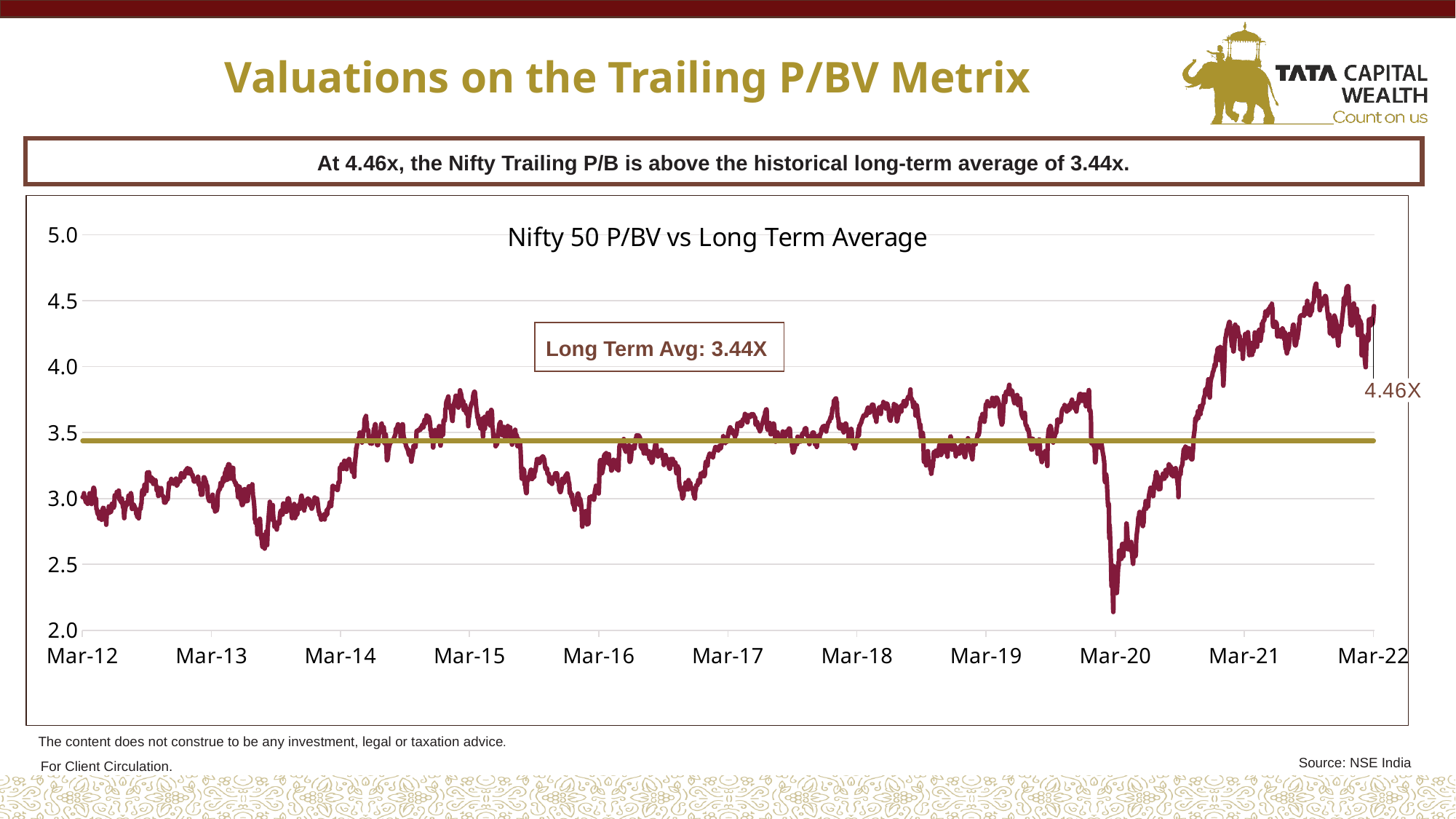
How many date labels are shown on the x axis? 11 What is the long-term average P/BV shown on the chart? 3.44X Is the P/BV value at Mar-12 greater or less than 3.5? less What is the range of the y axis? 2.0 to 5.0 Does the P/BV series rise or fall between Mar-20 and Mar-21? Rise What is the Nifty 50 P/BV value labelled at the end of the series (Mar-22)? 4.46X What is the title of the chart? Nifty 50 P/BV vs Long Term Average Is the lowest point of the P/BV series (around Mar-20) greater or less than 2.5? less By how much does the latest P/BV of 4.46X exceed the long-term average of 3.44X? 1.02 Which is larger: the latest Nifty P/BV or the long-term average? The latest Nifty P/BV (4.46X) What kind of chart is shown on the slide? Line chart Is the P/BV value at Mar-21 greater or less than 4.0? greater